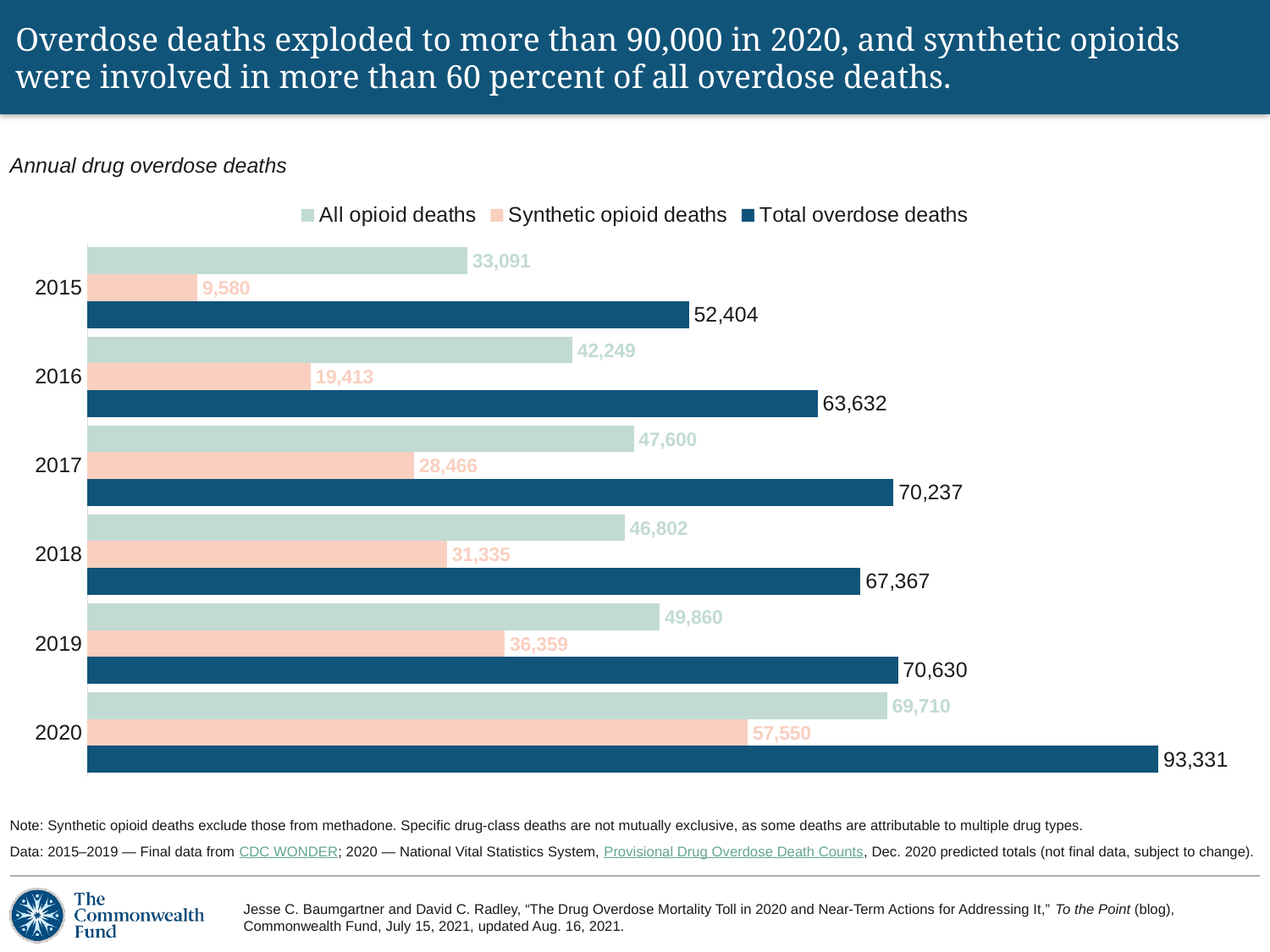
What was the number of total overdose deaths in 2020? 93,331 What is the subtitle of the chart? Annual drug overdose deaths What is the difference between total overdose deaths in 2020 and 2019? 22,701 What was the number of synthetic opioid deaths in 2015? 9,580 Which year had the lowest number of synthetic opioid deaths? 2015 Which was larger: all opioid deaths in 2017 or all opioid deaths in 2018? 2017 How many series does the legend list? 3 How many years are shown on the chart? 6 What kind of chart is shown on the slide? Bar chart Did synthetic opioid deaths rise or fall from 2015 to 2020? Rise What was the number of all opioid deaths in 2018? 46,802 Which year had the highest number of total overdose deaths? 2020